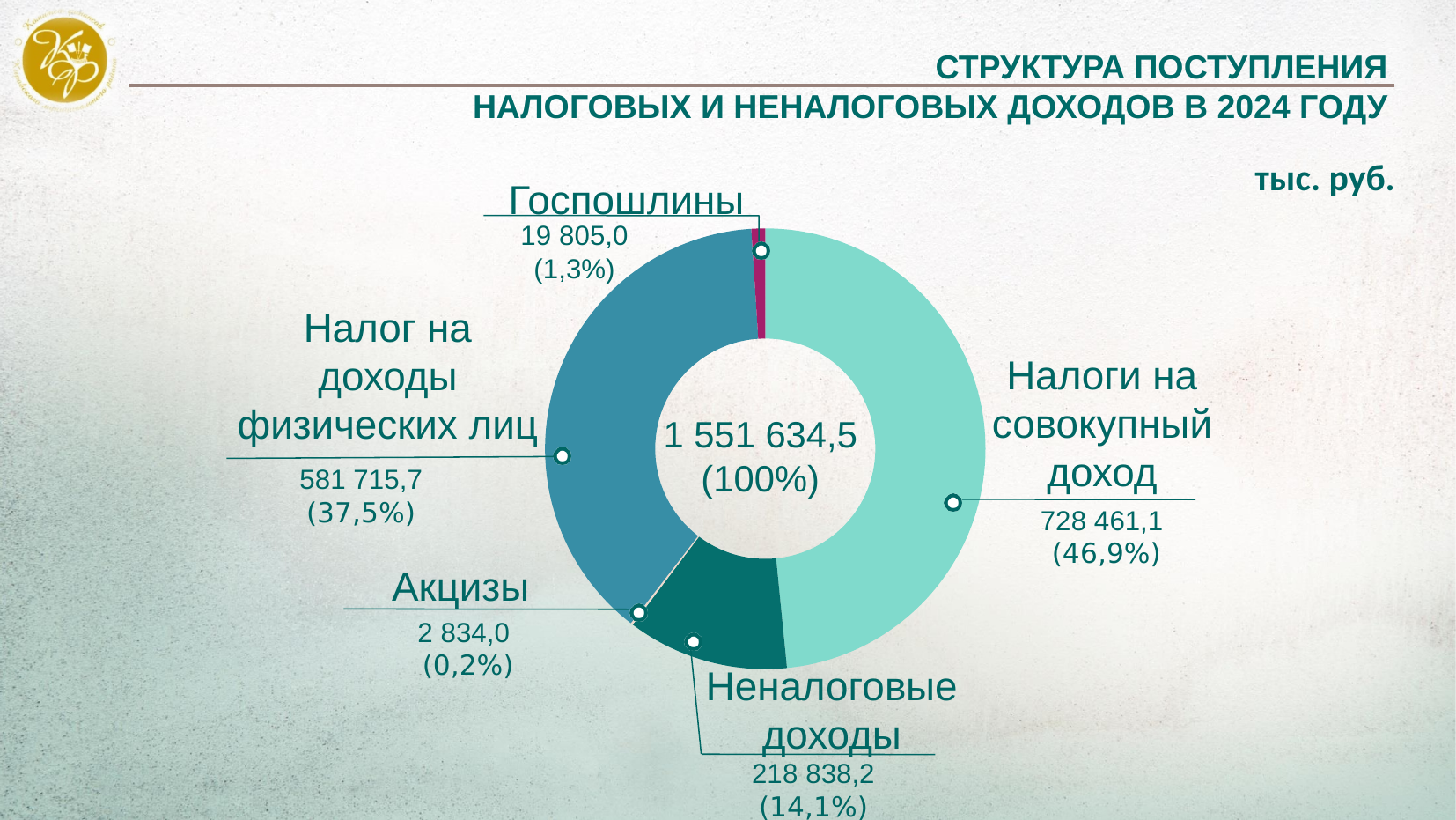
How many categories does the chart show? 5 What is the value for Неналоговые доходы? 218 838,2 What kind of chart is shown on the slide? Pie (donut) chart Which category has the smallest share of the chart? Акцизы What total value is shown in the centre of the chart? 1 551 634,5 What share of the total do Госпошлины represent? 1,3% What is the difference between the values for Налоги на совокупный доход and Налог на доходы физических лиц? 146 745,4 What is the value for Налоги на совокупный доход? 728 461,1 Which category has the largest share of the chart? Налоги на совокупный доход What is the value for Налог на доходы физических лиц? 581 715,7 What is the value for Акцизы? 2 834,0 What share of the total do Неналоговые доходы represent? 14,1%